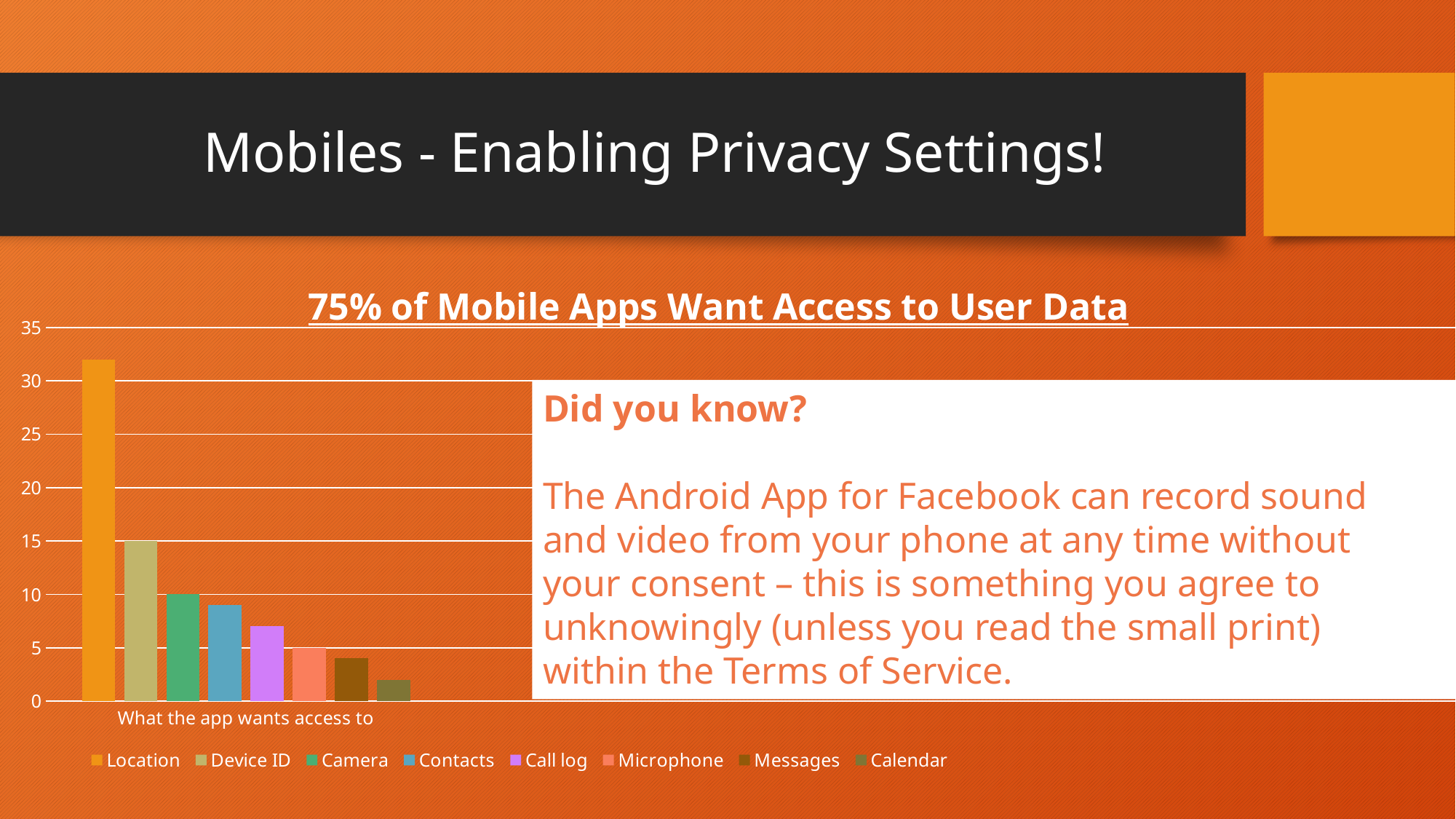
Which series has the shortest bar in the chart? Calendar What is the category label shown on the x axis of the chart? What the app wants access to What is the value for Microphone? 5 Which series has the tallest bar in the chart? Location What kind of chart is shown on the slide? bar chart Which is larger, the value for Camera or the value for Call log? Camera What is the title of the chart? 75% of Mobile Apps Want Access to User Data How many series does the chart's legend list? 8 Is the value for Messages greater or less than 5? less Is the value for Location greater or less than 30? greater What is the value for Device ID? 15 Is the value for Contacts greater or less than 10? less